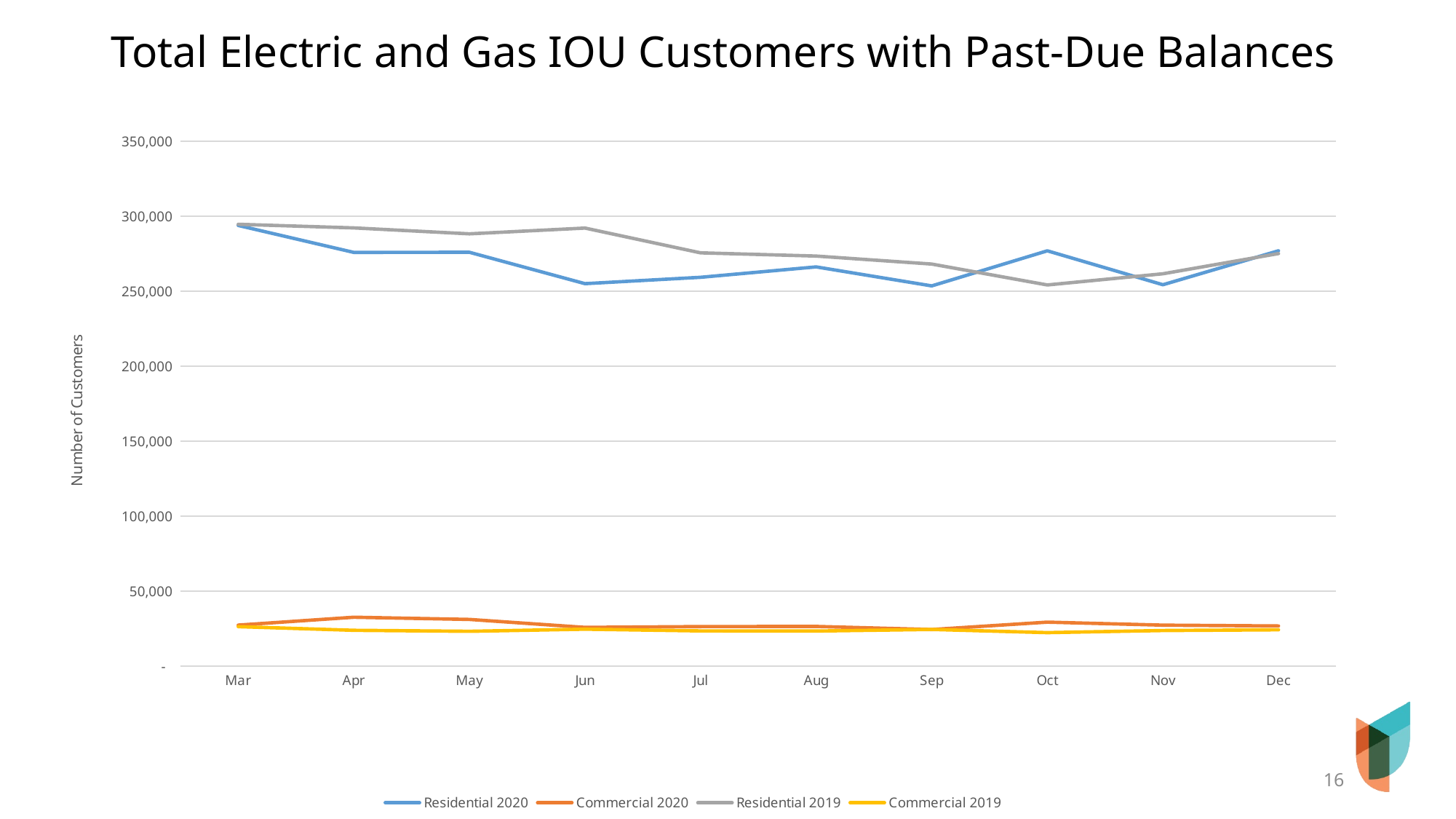
Is the value for Commercial 2020 in Apr greater or less than 50,000? less Is the value for Residential 2020 in Mar greater or less than 250,000? greater Is the value for Residential 2019 in Jun greater or less than 300,000? less What is the label on the vertical axis? Number of Customers In Jun, which is larger: Residential 2019 or Residential 2020? Residential 2019 How many series does the legend list? 4 In Oct, which is larger: Residential 2020 or Residential 2019? Residential 2020 What kind of chart is shown on the slide? line chart How many months are shown along the x axis? 10 Does the Residential 2019 line rise or fall overall from Mar to Oct? fall In which month is Residential 2019 at its lowest? Oct In which month is Residential 2020 at its highest? Mar